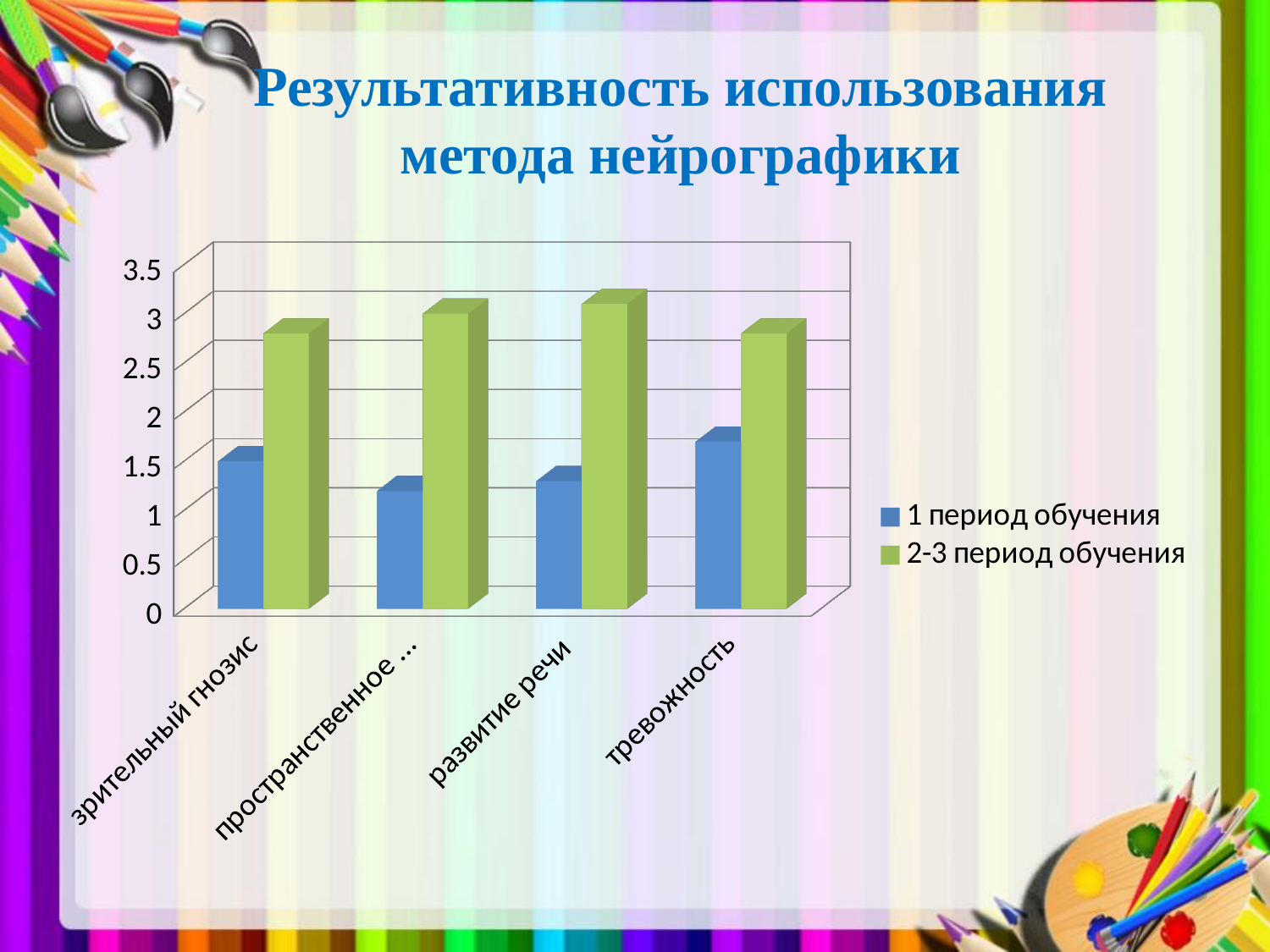
For развитие речи, which series has the larger value: 1 период обучения or 2-3 период обучения? 2-3 период обучения Which category has the highest value in the series 1 период обучения? тревожность Is the value for зрительный гнозис in the series 2-3 период обучения greater or less than 2? greater Is the value for зрительный гнозис in the series 1 период обучения greater or less than 2? less How many categories are shown on the x axis of the chart? 4 What kind of chart is shown on the slide? bar chart Is the value for тревожность in the series 1 период обучения greater or less than 1? greater Which series is shown in green in the chart? 2-3 период обучения How many series does the legend list? 2 What is the title of the slide containing the chart? Результативность использования метода нейрографики For тревожность, which series has the larger value: 1 период обучения or 2-3 период обучения? 2-3 период обучения